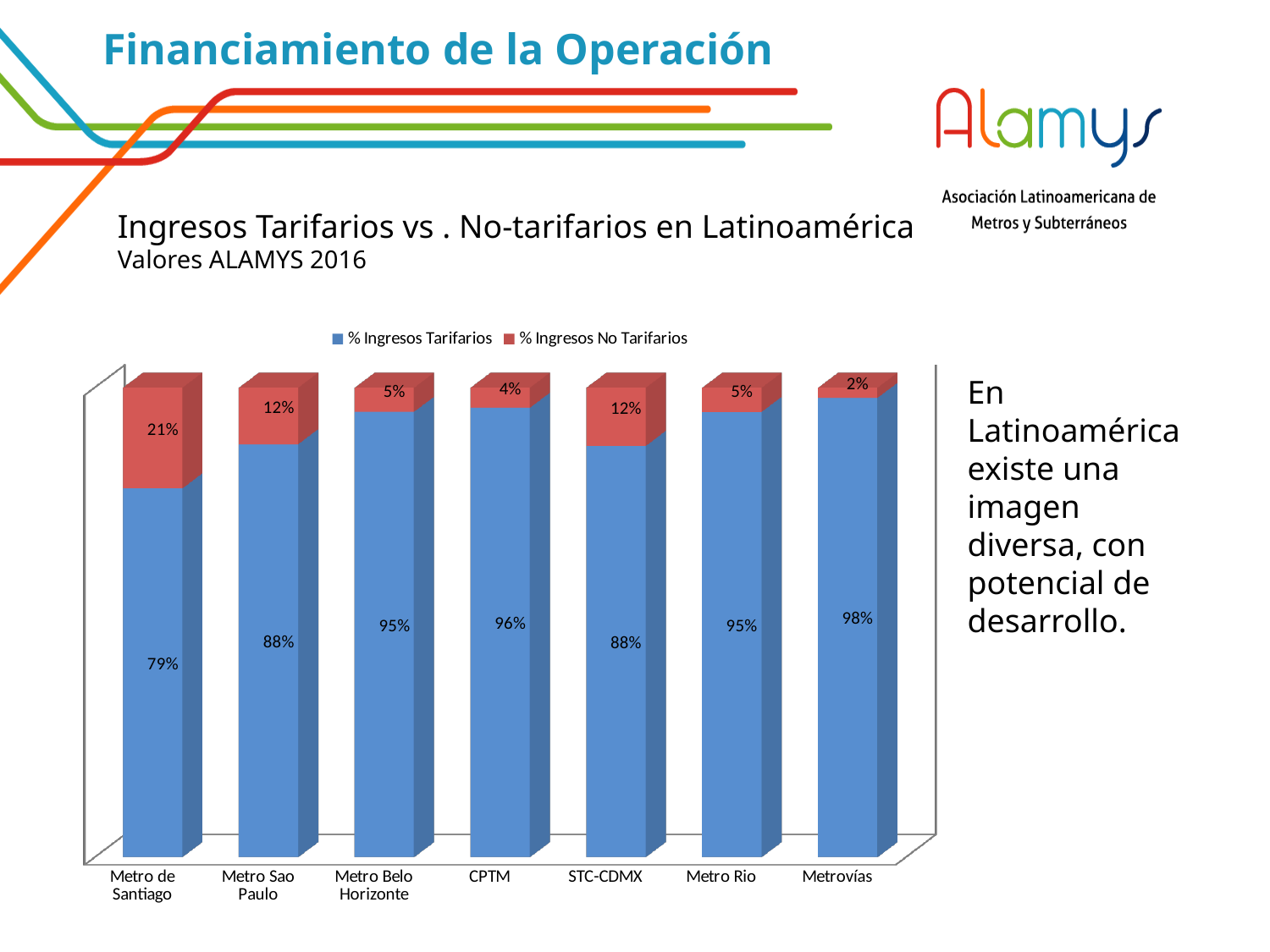
Which category has the highest % Ingresos Tarifarios? Metrovías Which category has the highest % Ingresos No Tarifarios? Metro de Santiago Which category has the lowest % Ingresos Tarifarios? Metro de Santiago Which is larger, the % Ingresos Tarifarios for Metro Sao Paulo or for Metro Rio? Metro Rio Which colour represents % Ingresos No Tarifarios in the chart? Red How many categories are shown on the x axis of the chart? 7 How many series does the legend list? 2 What is the % Ingresos Tarifarios value for CPTM? 96% What is the difference between the % Ingresos No Tarifarios for Metro de Santiago and for Metrovías? 19% What is the % Ingresos Tarifarios value for Metro de Santiago? 79% What kind of chart is shown on the slide? Stacked bar chart What is the % Ingresos No Tarifarios value for STC-CDMX? 12%